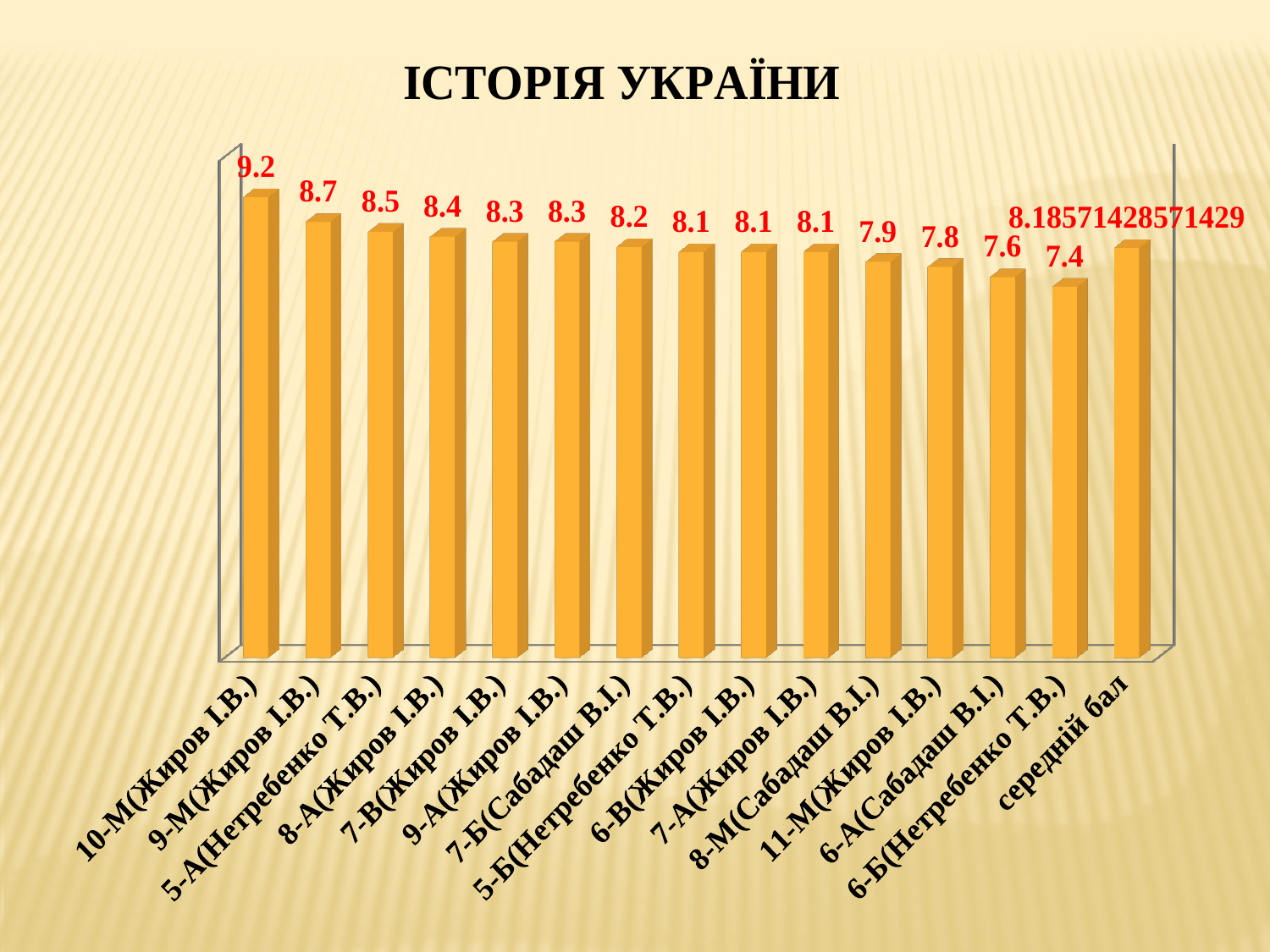
What is the title of the slide? ІСТОРІЯ УКРАЇНИ What is the value for 10-М(Жиров І.В.)? 9.2 What is the value for 8-М(Сабадаш В.І.)? 7.9 What is the value for 6-Б(Нетребенко Т.В.)? 7.4 How many bars are plotted on the chart? 15 Which is larger, the value for 11-М(Жиров І.В.) or the value for 6-А(Сабадаш В.І.)? 11-М(Жиров І.В.) Which category has the lowest value? 6-Б(Нетребенко Т.В.) What is the difference between the values for 9-М(Жиров І.В.) and 5-А(Нетребенко Т.В.)? 0.2 What kind of chart is shown on the slide? Bar chart What is the difference between the values for 10-М(Жиров І.В.) and 6-Б(Нетребенко Т.В.)? 1.8 What is the value shown for середній бал? 8.18571428571429 Which category has the highest value? 10-М(Жиров І.В.)